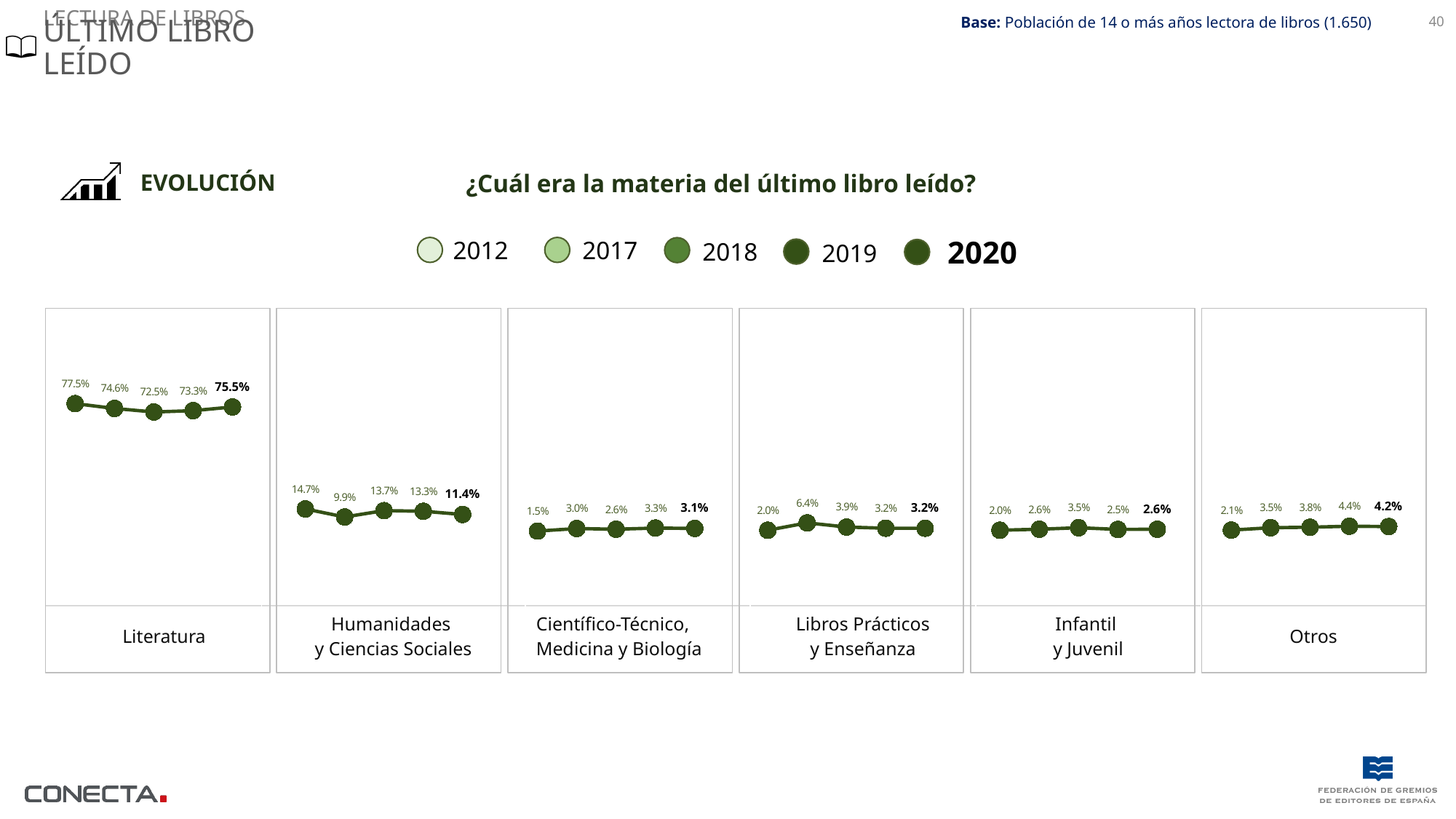
In the Literatura chart, what is the difference between the 2012 value and the 2018 value? 5.0% In the Literatura chart, what is the value for 2020? 75.5% In the Otros chart, what is the value for 2019? 4.4% In the Literatura chart, which year has the highest value? 2012 In the Humanidades y Ciencias Sociales chart, what is the value for 2017? 9.9% In the Libros Prácticos y Enseñanza chart, what is the value for 2017? 6.4% In the Infantil y Juvenil chart, which year has the larger value, 2018 or 2019? 2018 What kind of chart is used in each panel? Line chart How many years does the legend list? 5 How many category panels (subject areas) are shown on the slide? 6 In the Humanidades y Ciencias Sociales chart, what is the difference between the 2012 value and the 2020 value? 3.3% In the Científico-Técnico, Medicina y Biología chart, which year has the lowest value? 2012